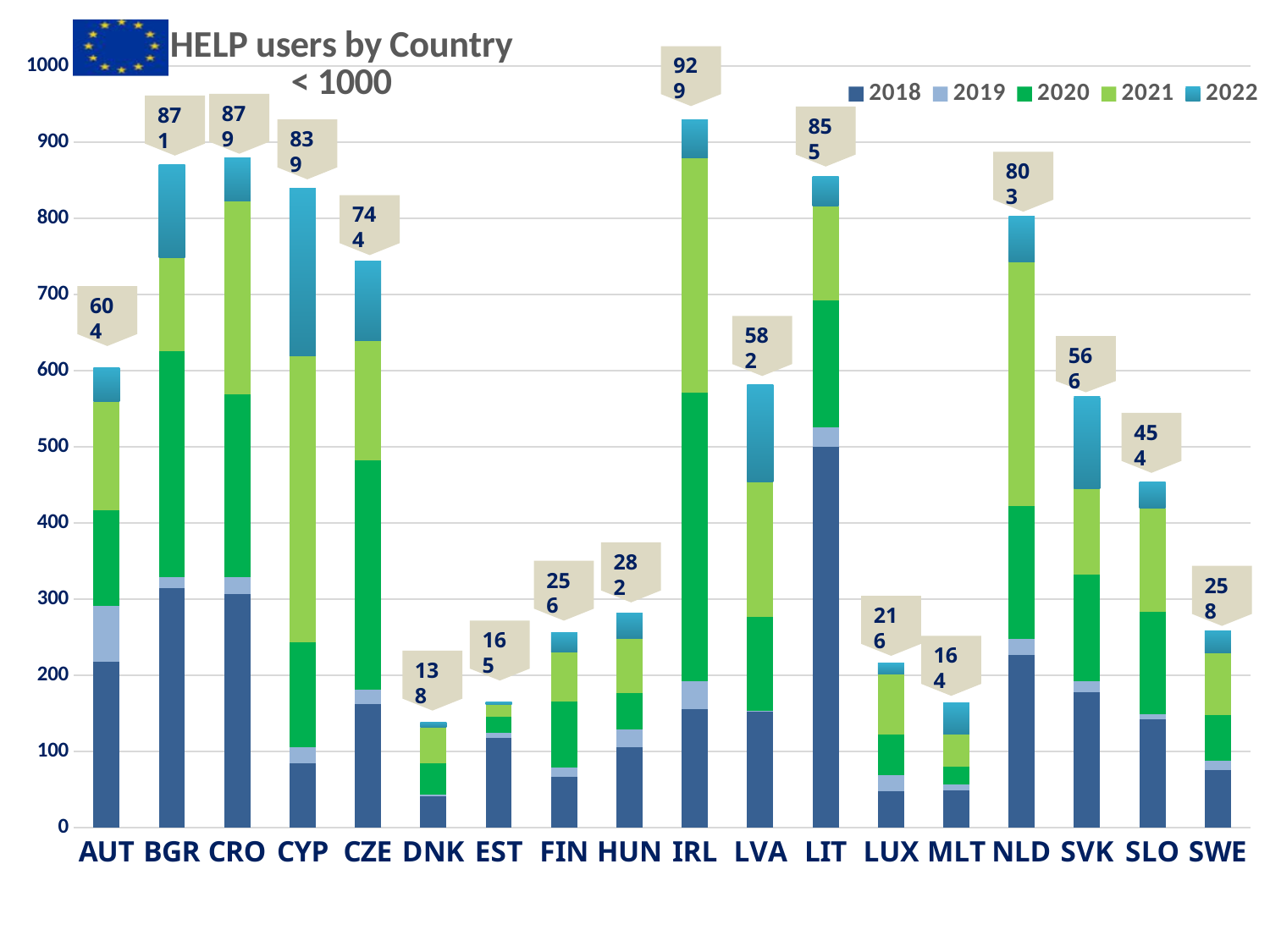
What kind of chart is shown on the slide? Stacked bar chart How many series does the legend list? 5 What is the total number of HELP users for CZE? 744 What is the total number of HELP users for LUX? 216 How many countries are shown on the x axis? 18 Which country has the lowest total of HELP users? DNK Is the 2018 value for LIT greater or less than 400? greater Which country has the highest total of HELP users? IRL What is the difference between the totals for CRO and BGR? 8 What is the total number of HELP users for IRL? 929 What is the difference between the totals for IRL and LIT? 74 Which has a larger total of HELP users, NLD or CYP? CYP